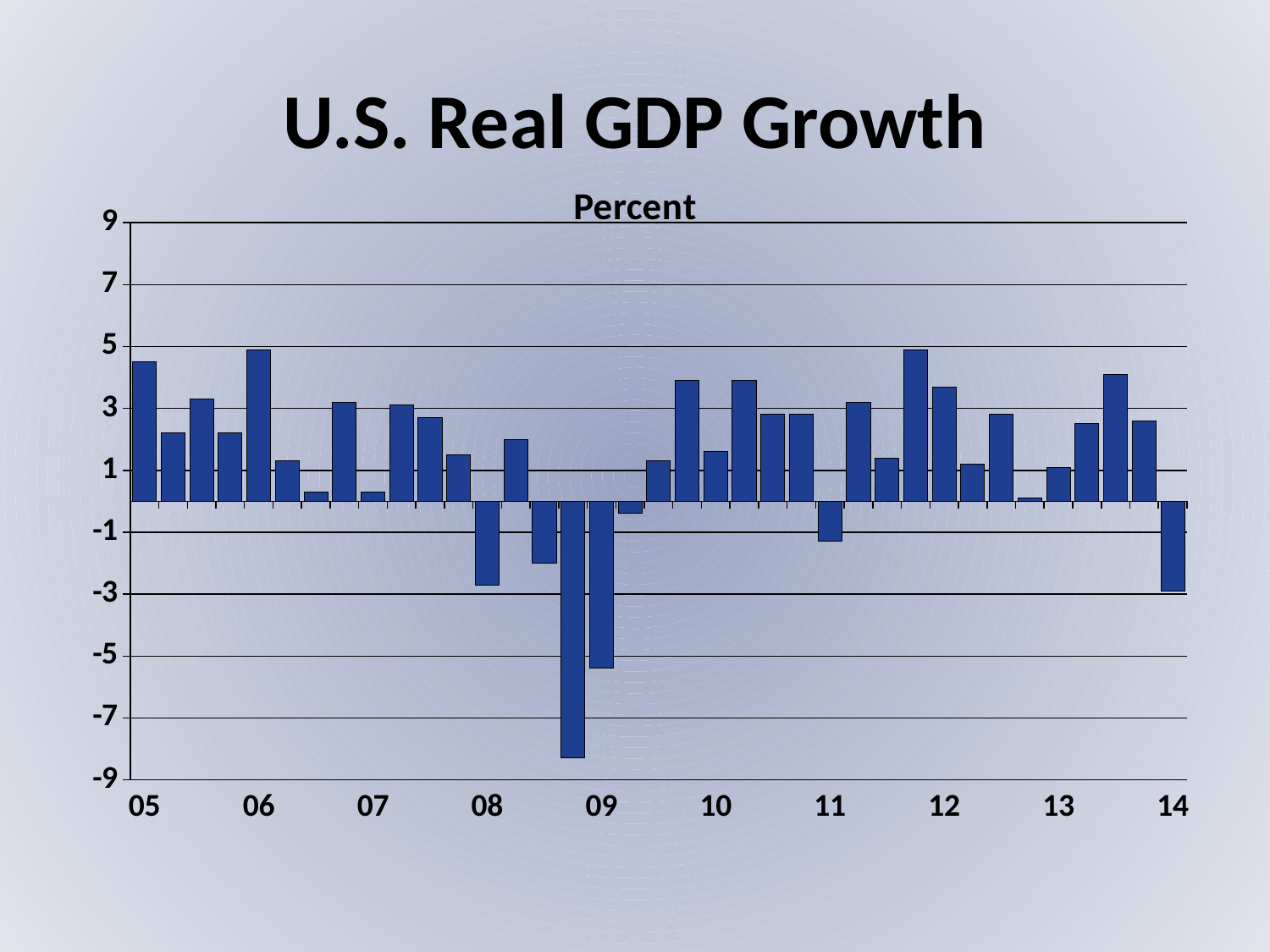
Which is larger, the first bar for 12 or the first bar for 13? the first bar for 12 Is the value of the first bar for 05 greater or less than 3? greater Which is larger, the first bar for 05 or the bar at 14? the first bar for 05 What is the title of the chart? U.S. Real GDP Growth Is the value of the lowest bar on the chart greater or less than -7? less Is the value of the bar at 14 greater or less than -1? less How many year labels appear along the x axis? 10 What is the highest value shown on the vertical axis? 9 What kind of chart is shown on the slide? bar chart What unit label is shown above the vertical axis? Percent